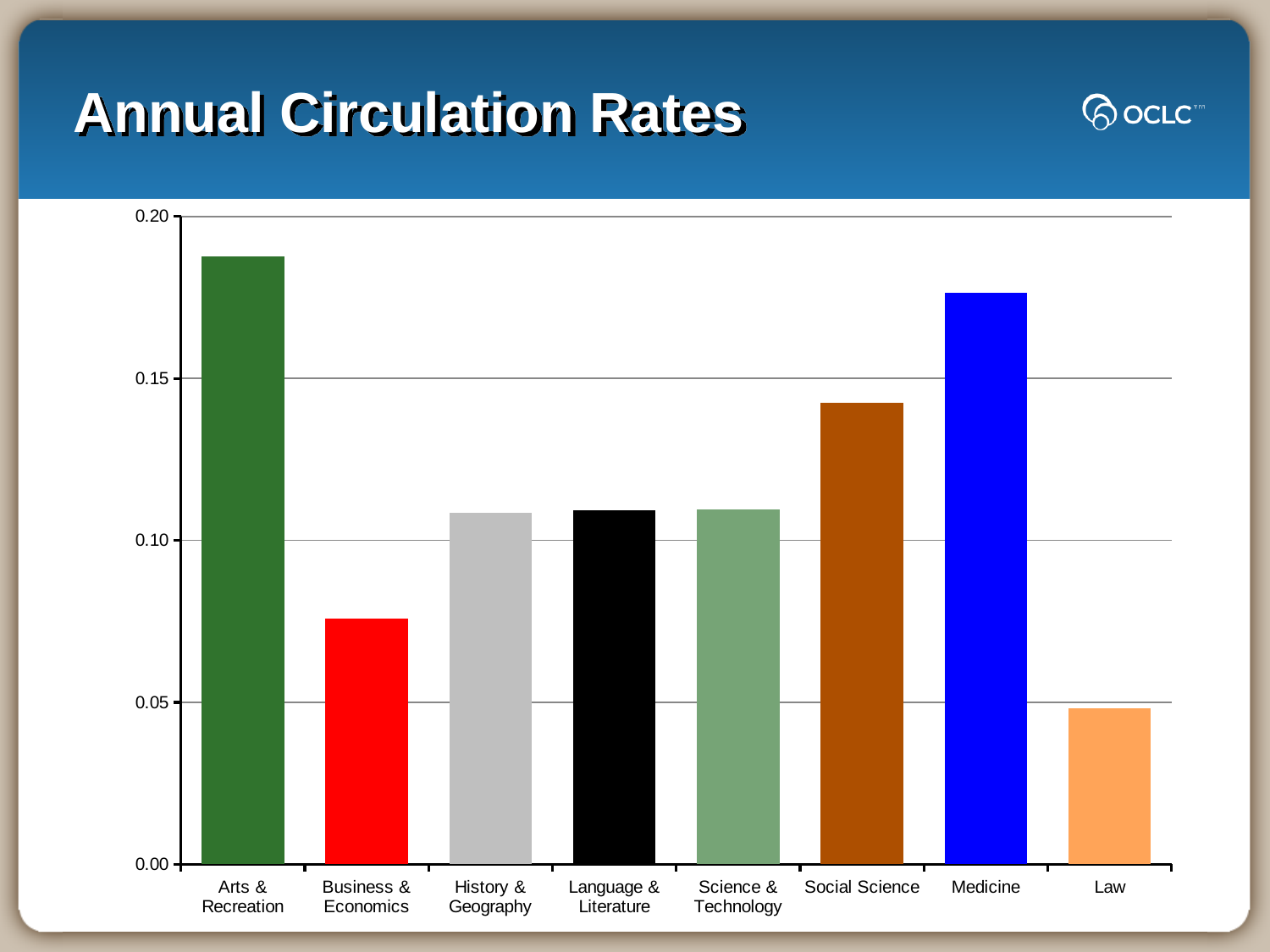
Which is larger, the value for Social Science or the value for Business & Economics? Social Science Which category has the highest annual circulation rate? Arts & Recreation What is the title of the slide? Annual Circulation Rates Is the value for Arts & Recreation greater or less than 0.15? greater Is the value for Social Science greater or less than 0.15? less What colour is the bar for Medicine? Blue Is the value for Medicine greater or less than 0.15? greater How many subject categories are plotted on the chart? 8 Which category has the lowest annual circulation rate? Law What kind of chart is shown on the slide? Bar chart